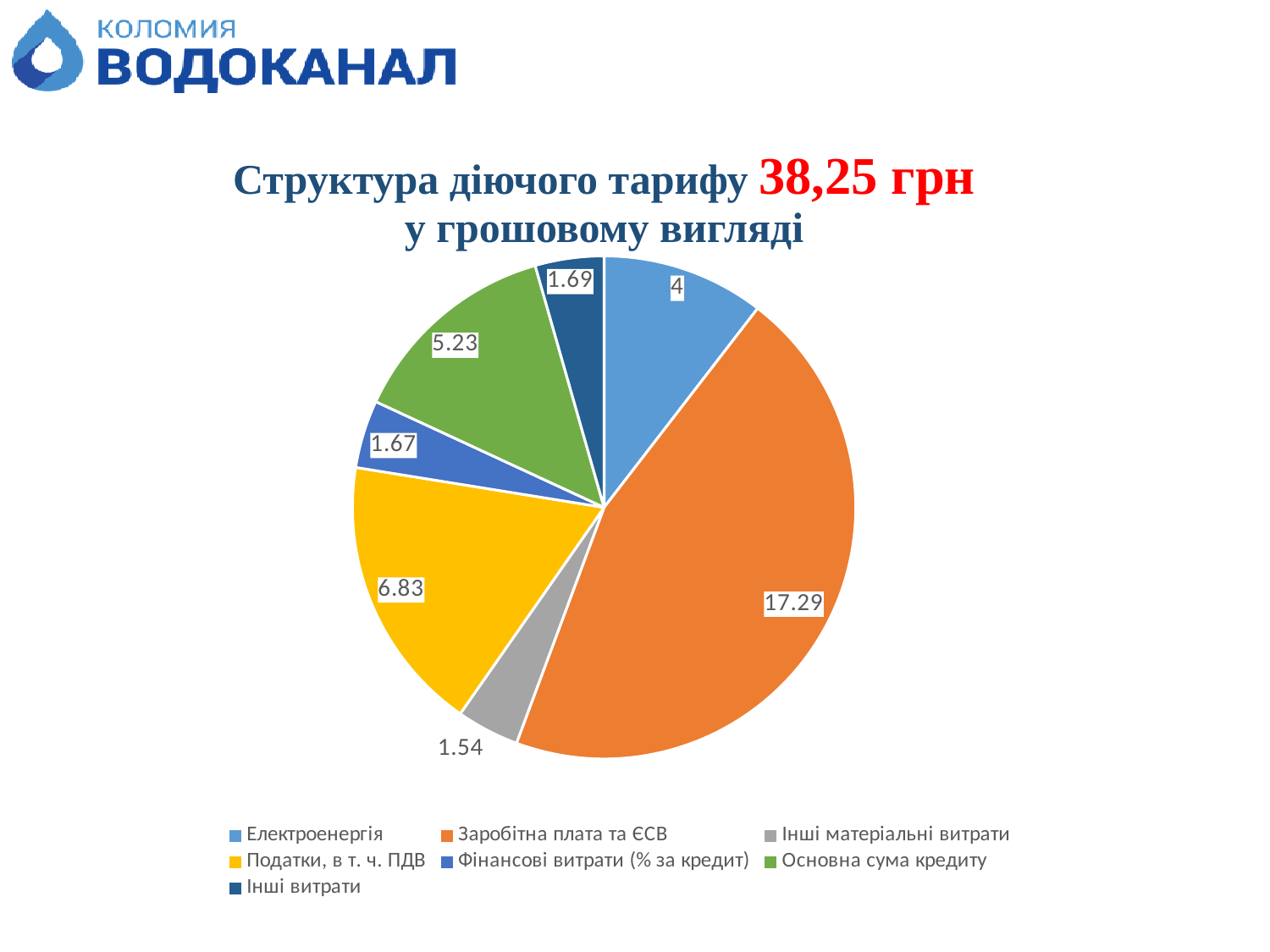
What type of chart is shown on the slide? Pie chart What is the value for Електроенергія? 4 What is the total of all slice values in the pie chart? 38.25 What is the difference between the values for Заробітна плата та ЄСВ and Податки, в т. ч. ПДВ? 10.46 How many slices does the pie chart have? 7 Which category has the smallest slice of the pie? Інші матеріальні витрати What is the value for Податки, в т. ч. ПДВ? 6.83 What is the value for Основна сума кредиту? 5.23 What is the value for Заробітна плата та ЄСВ? 17.29 What tariff amount is stated in the chart title? 38,25 грн Which is larger, the value for Основна сума кредиту or the value for Електроенергія? Основна сума кредиту Which category has the largest slice of the pie? Заробітна плата та ЄСВ